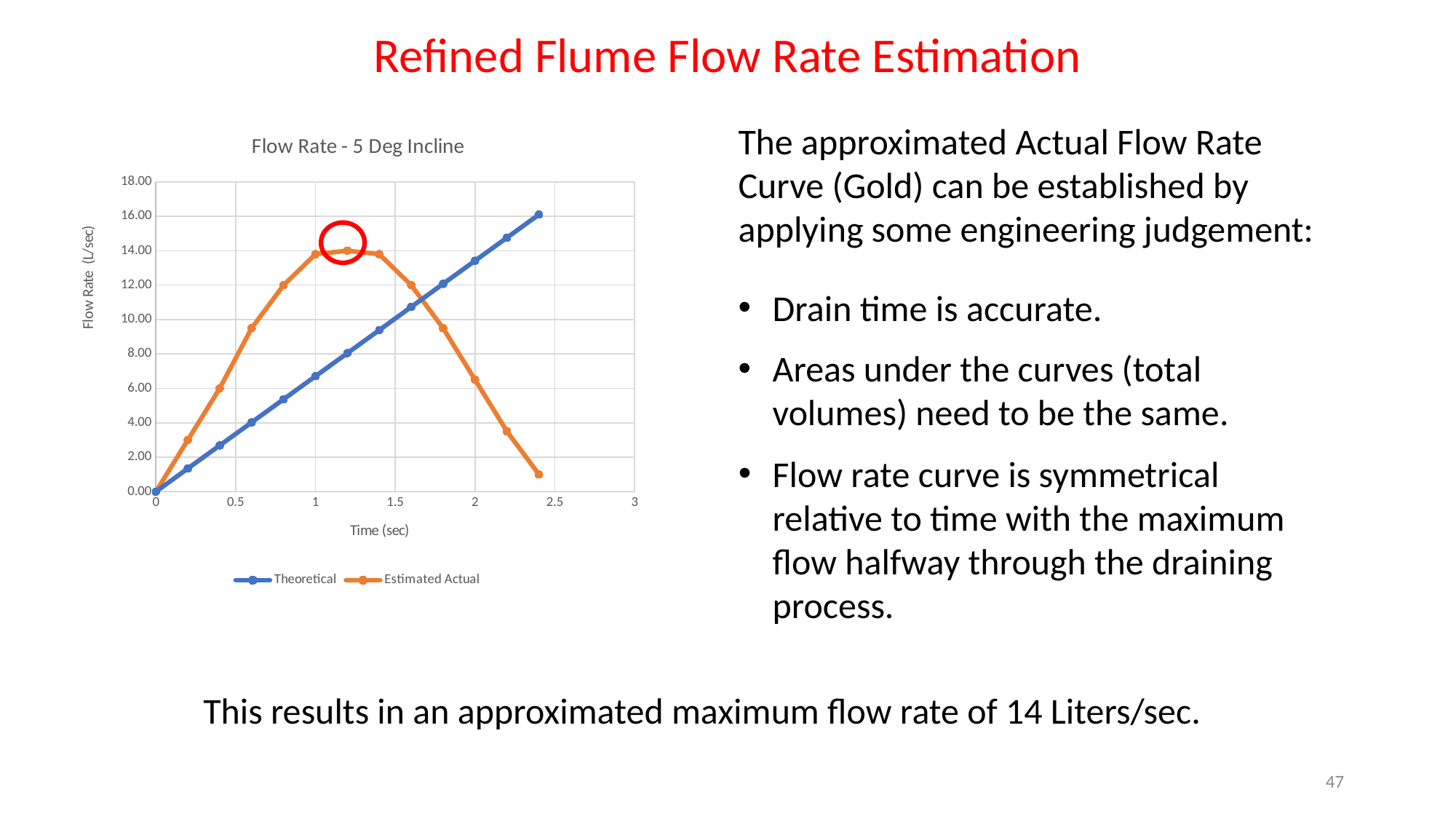
What kind of chart is shown on the slide? line chart Is the value of the Estimated Actual series at time 1.2 greater or less than 12.00? greater Is the value of the Theoretical series at time 2.4 greater or less than 14.00? greater What is the value of the Theoretical series at time 0? 0.00 Is the value of the Estimated Actual series at time 2.4 greater or less than 2.00? less At time 2.0, which series has the larger value, Theoretical or Estimated Actual? Theoretical How many series does the chart legend list? 2 At time 0.6, which series has the larger value, Theoretical or Estimated Actual? Estimated Actual What is the label of the chart's x axis? Time (sec) Does the Theoretical series rise or fall as time increases along the x axis? rise What is the title of the chart? Flow Rate - 5 Deg Incline